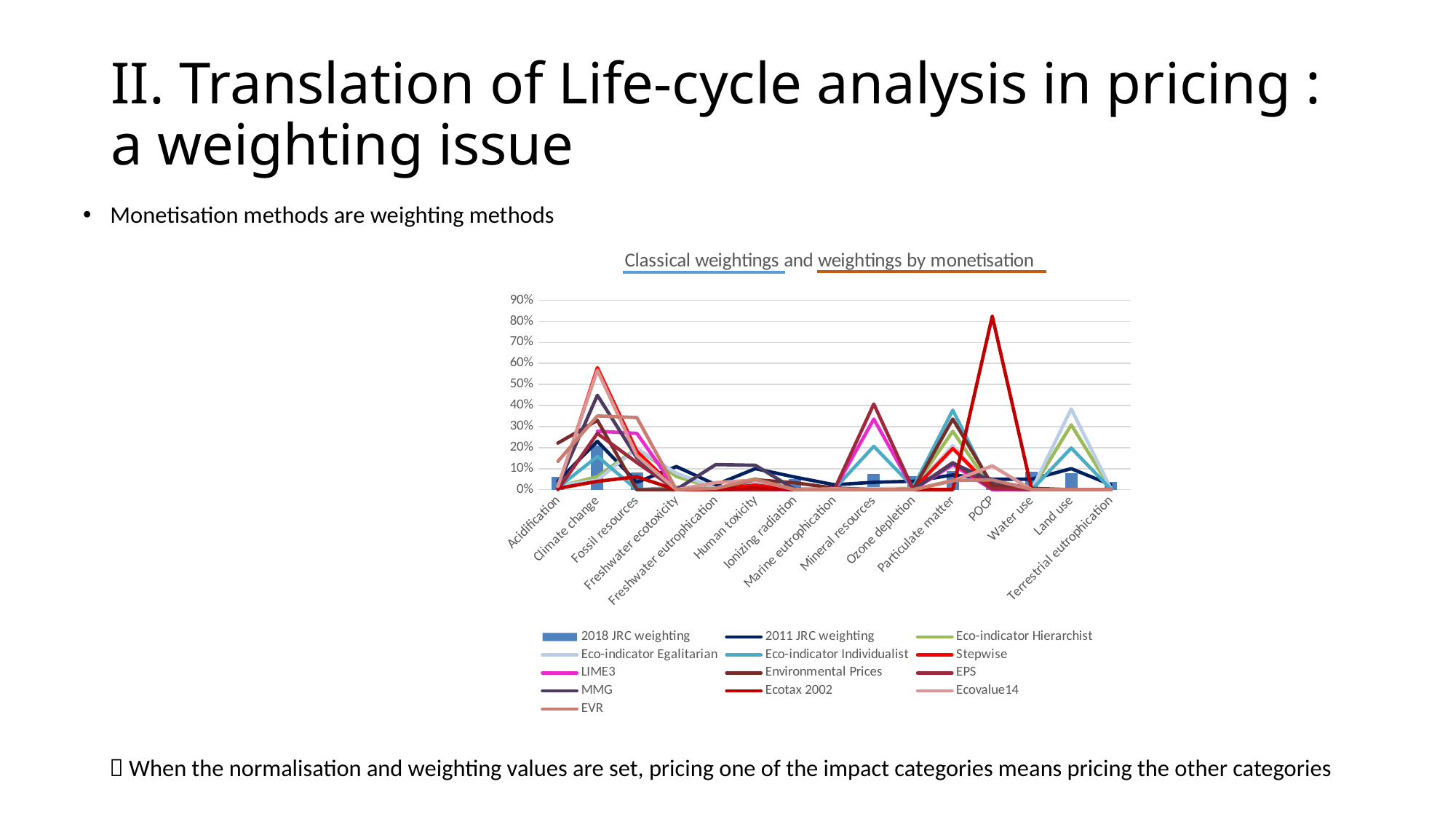
Is the value of Eco-indicator Egalitarian at Land use greater or less than 30%? greater What is the title of the chart? Classical weightings and weightings by monetisation Which series in the chart is drawn as bars rather than a line? 2018 JRC weighting What is the highest value shown on the vertical axis of the chart? 90% Is the value of Stepwise at Climate change greater or less than 50%? greater How many series does the chart legend list? 13 Which is larger: the Ecotax 2002 value at POCP or the Stepwise value at Climate change? Ecotax 2002 at POCP At which impact category does the Stepwise line reach its highest value? Climate change At which impact category does the Eco-indicator Egalitarian line reach its highest value? Land use Is the value of Ecotax 2002 at POCP greater or less than 70%? greater At which impact category does the Ecotax 2002 line reach its highest value? POCP How many impact categories are shown along the x axis of the chart? 15